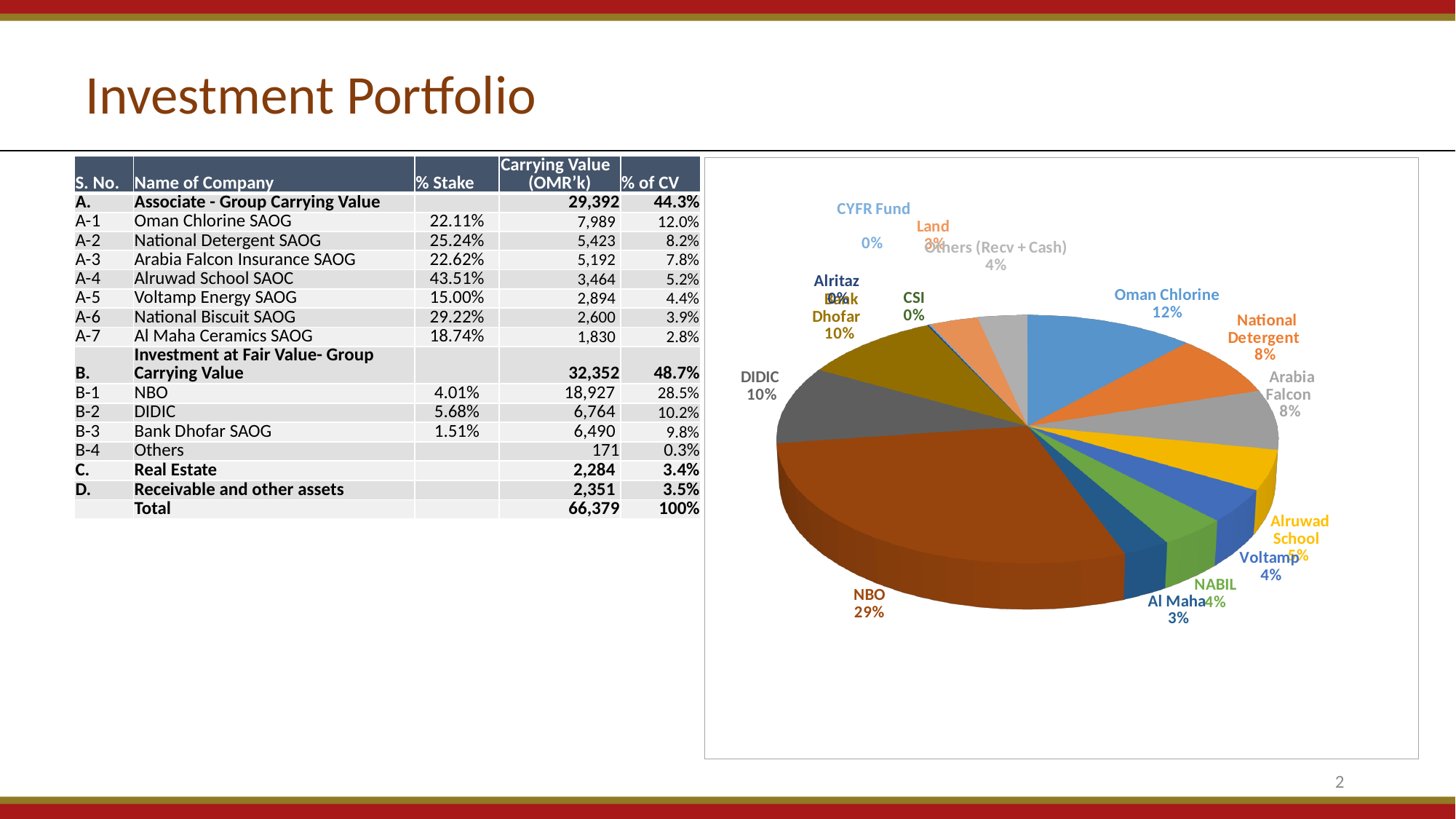
What colour is the NBO slice in the pie chart? brown What share of the pie chart does DIDIC hold? 10% What is the difference between the NBO share and the DIDIC share in the pie chart? 19% What share of the pie chart does Arabia Falcon hold? 8% What share of the pie chart does Alruwad School hold? 5% What is the difference between the Oman Chlorine share and the Voltamp share in the pie chart? 8% Which slice of the pie chart has the largest share? NBO Which is larger in the pie chart, the share for Oman Chlorine or the share for National Detergent? Oman Chlorine What kind of chart is shown on the slide? pie chart